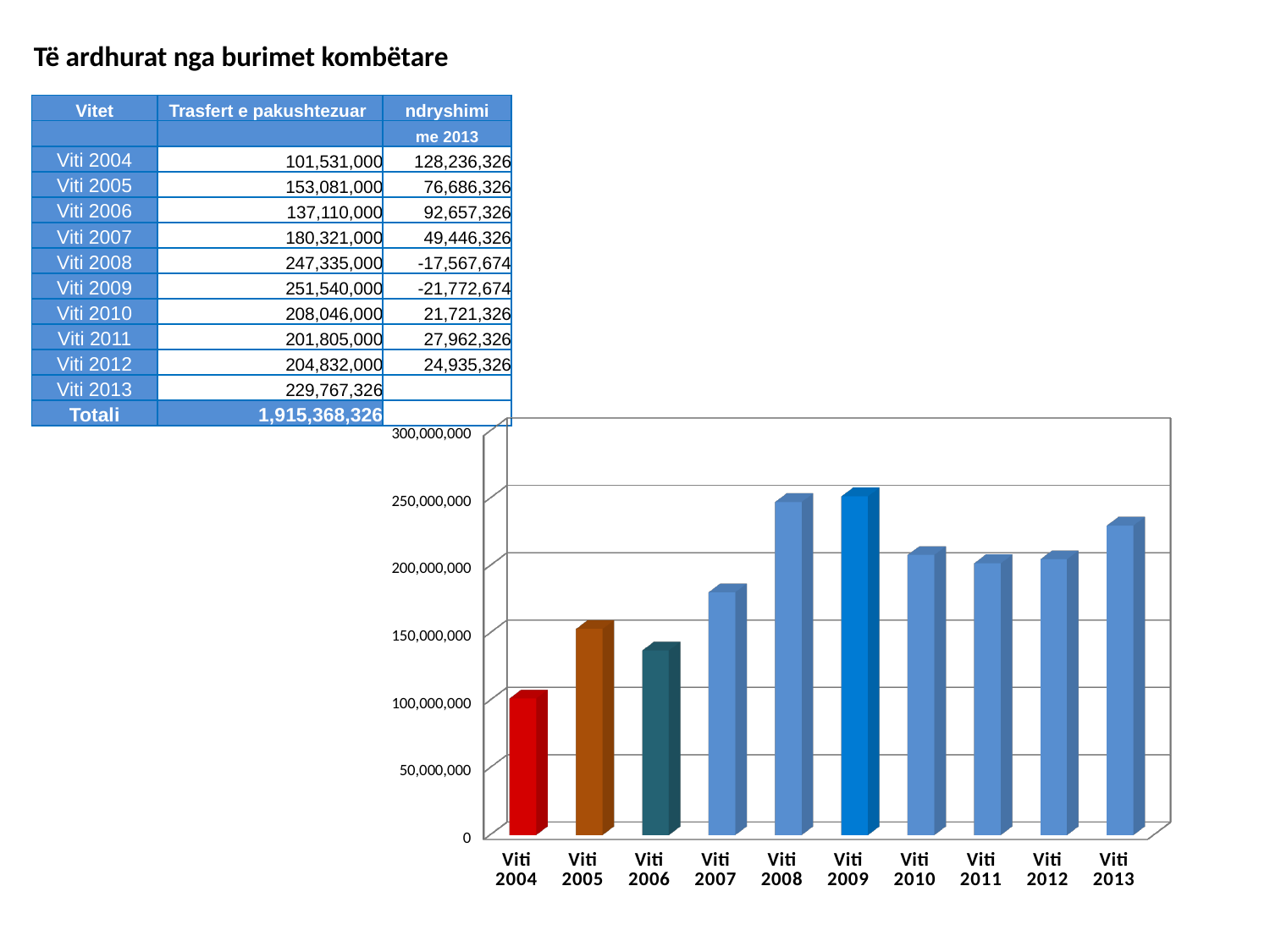
Which year has the shortest bar in the chart? Viti 2004 Is the value for Viti 2007 greater or less than 200,000,000? less What kind of chart is shown on the slide? bar chart How many bars (years) does the chart show? 10 According to the table on the slide, what is the value of Trasfert e pakushtezuar for Viti 2009? 251,540,000 Which year has the tallest bar in the chart? Viti 2009 Is the value for Viti 2006 greater or less than 150,000,000? less Do the bars rise or fall from Viti 2007 to Viti 2009? rise According to the table on the slide, what is the Totali of Trasfert e pakushtezuar? 1,915,368,326 What colour is the bar for Viti 2004 in the chart? red Is the value for Viti 2013 greater or less than 200,000,000? greater Which is larger, the bar for Viti 2005 or the bar for Viti 2006? Viti 2005